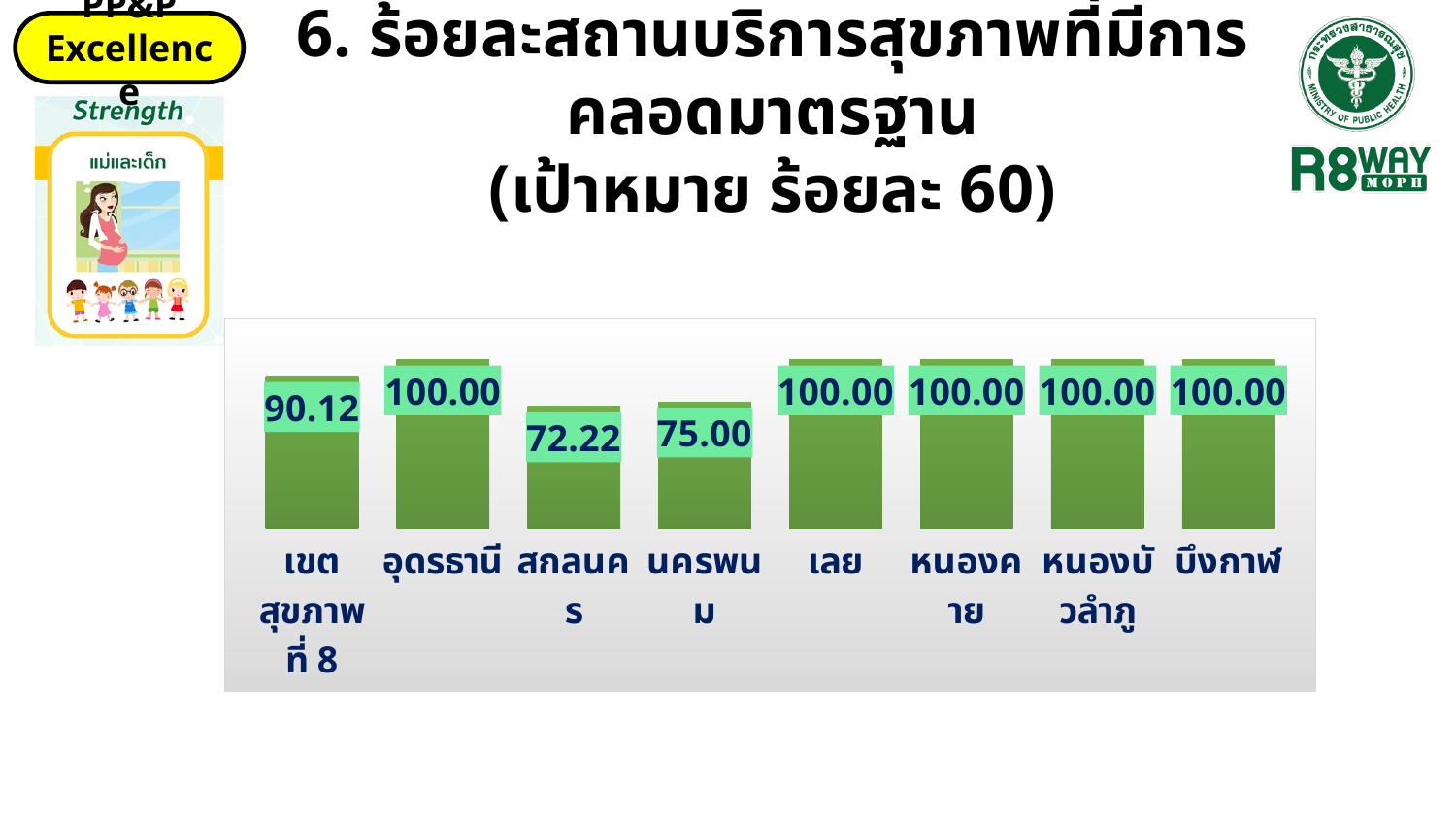
What kind of chart is shown on the slide? Bar chart What is the difference between the values for นครพนม and สกลนคร? 2.78 How many categories are shown in the chart? 8 What is the value for อุดรธานี? 100.00 Which is larger, the value for เขตสุขภาพที่ 8 or the value for นครพนม? เขตสุขภาพที่ 8 What is the target percentage stated in the slide title? ร้อยละ 60 What is the value for เขตสุขภาพที่ 8? 90.12 Which category has the lowest value? สกลนคร What is the value for สกลนคร? 72.22 How many categories have a value of 100.00? 5 What is the difference between the values for อุดรธานี and เขตสุขภาพที่ 8? 9.88 What is the value for นครพนม? 75.00